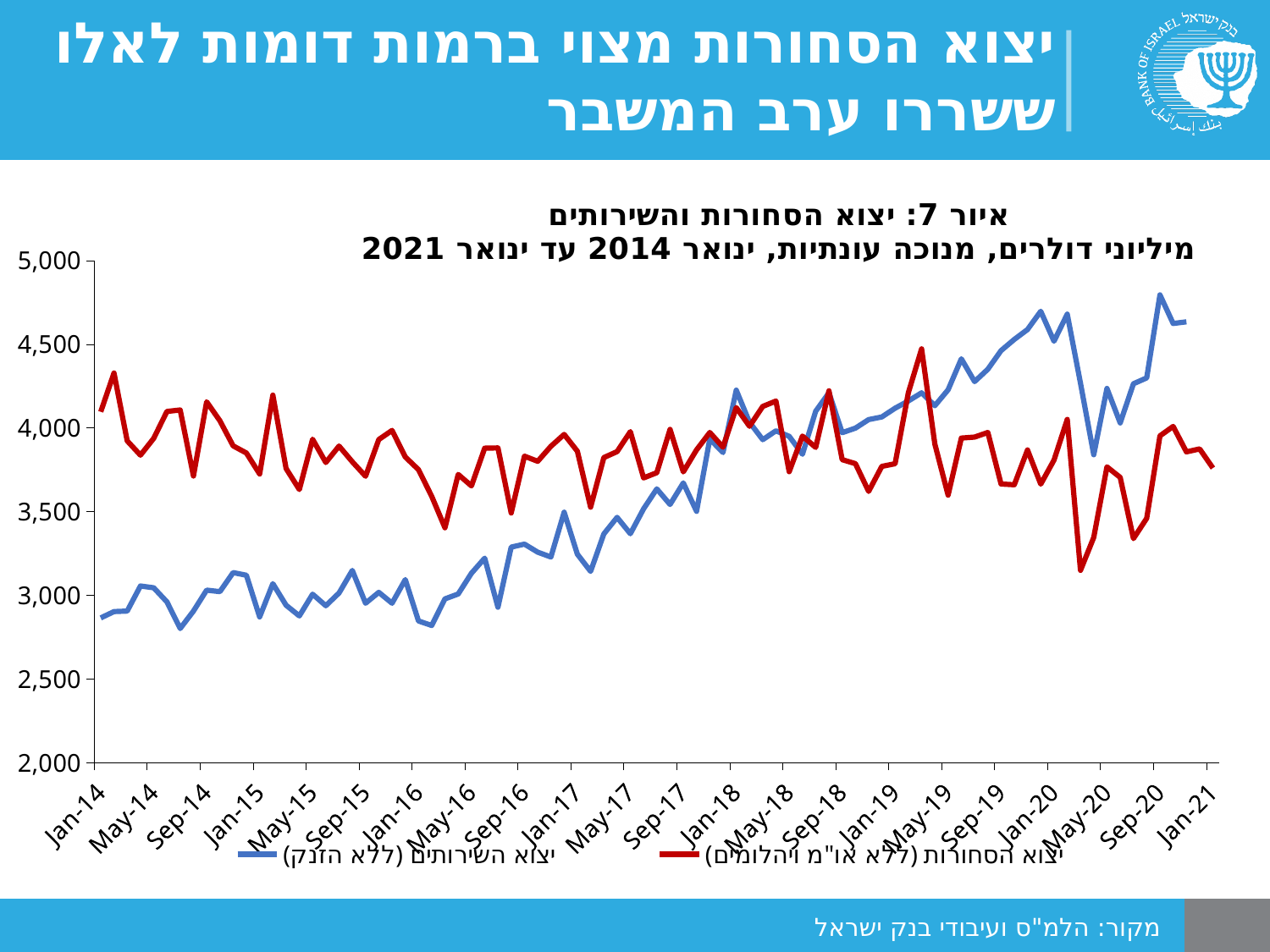
What kind of chart is shown on the slide? line chart Which colour is used for the services exports series (יצוא השירותים (ללא הזנק))? blue Does the blue services exports series generally rise or fall from Jan-14 to Jan-21? rise How many series does the legend list? 2 Is the value of the blue services exports series at Sep-20 greater or less than 4,000? greater At Jan-14, which series is higher: the blue services exports or the red goods exports? red goods exports Is the value of the blue services exports series at Jan-14 greater or less than 3,000? less Is the value of the red goods exports series at May-20 greater or less than 3,500? greater What is the title of the chart (first line)? איור 7: יצוא הסחורות והשירותים